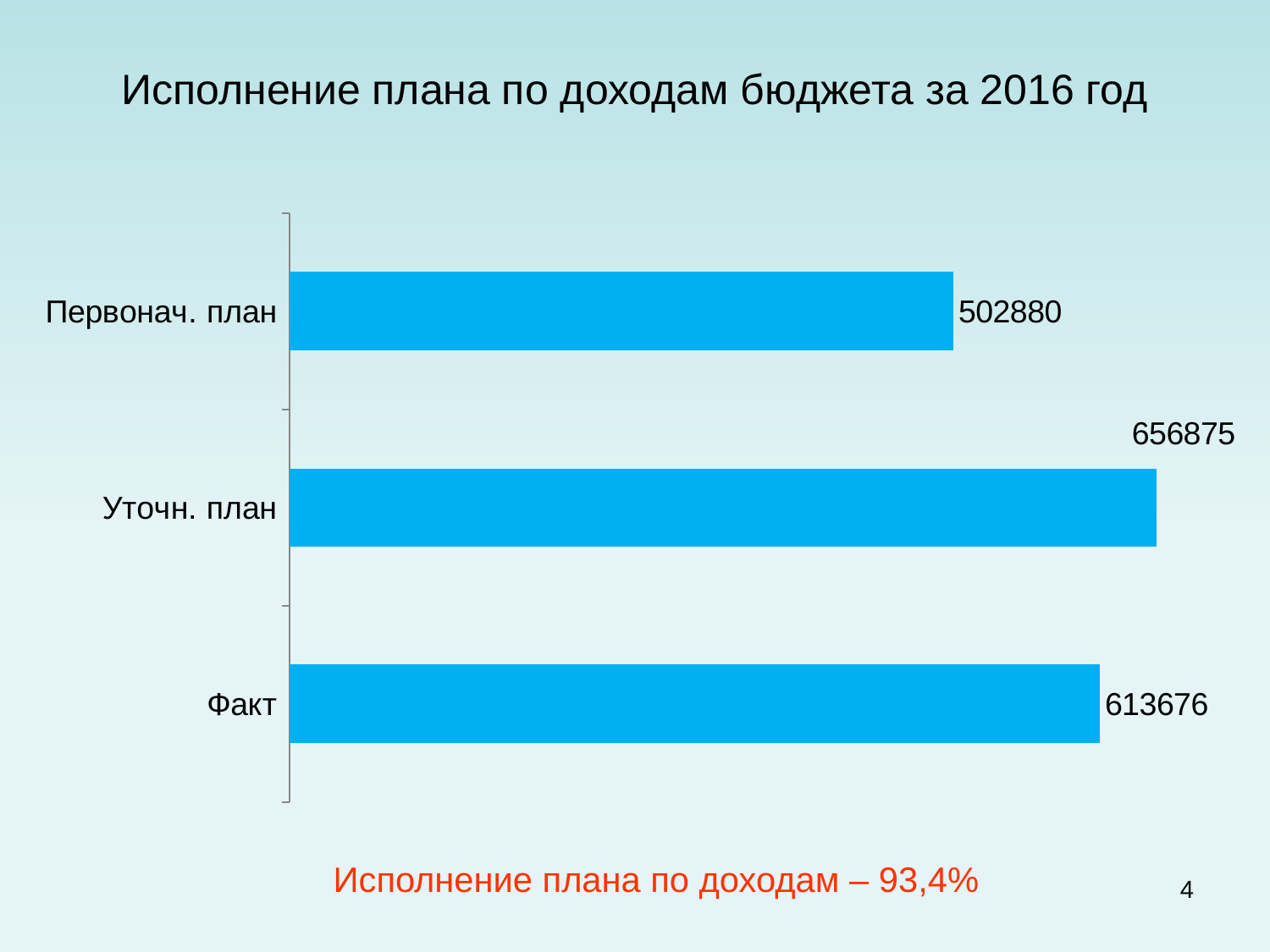
Which is larger, Первонач. план or Факт? Факт What is the value for Первонач. план? 502880 What kind of chart is shown on the slide? bar chart Which category has the lowest value? Первонач. план What is the value for Факт? 613676 What is the difference between Факт and Первонач. план? 110796 Which is larger, Уточн. план or Факт? Уточн. план Which category has the highest value? Уточн. план How many categories are shown in the chart? 3 What is the value for Уточн. план? 656875 What is the title of the slide? Исполнение плана по доходам бюджета за 2016 год What is the difference between Уточн. план and Факт? 43199